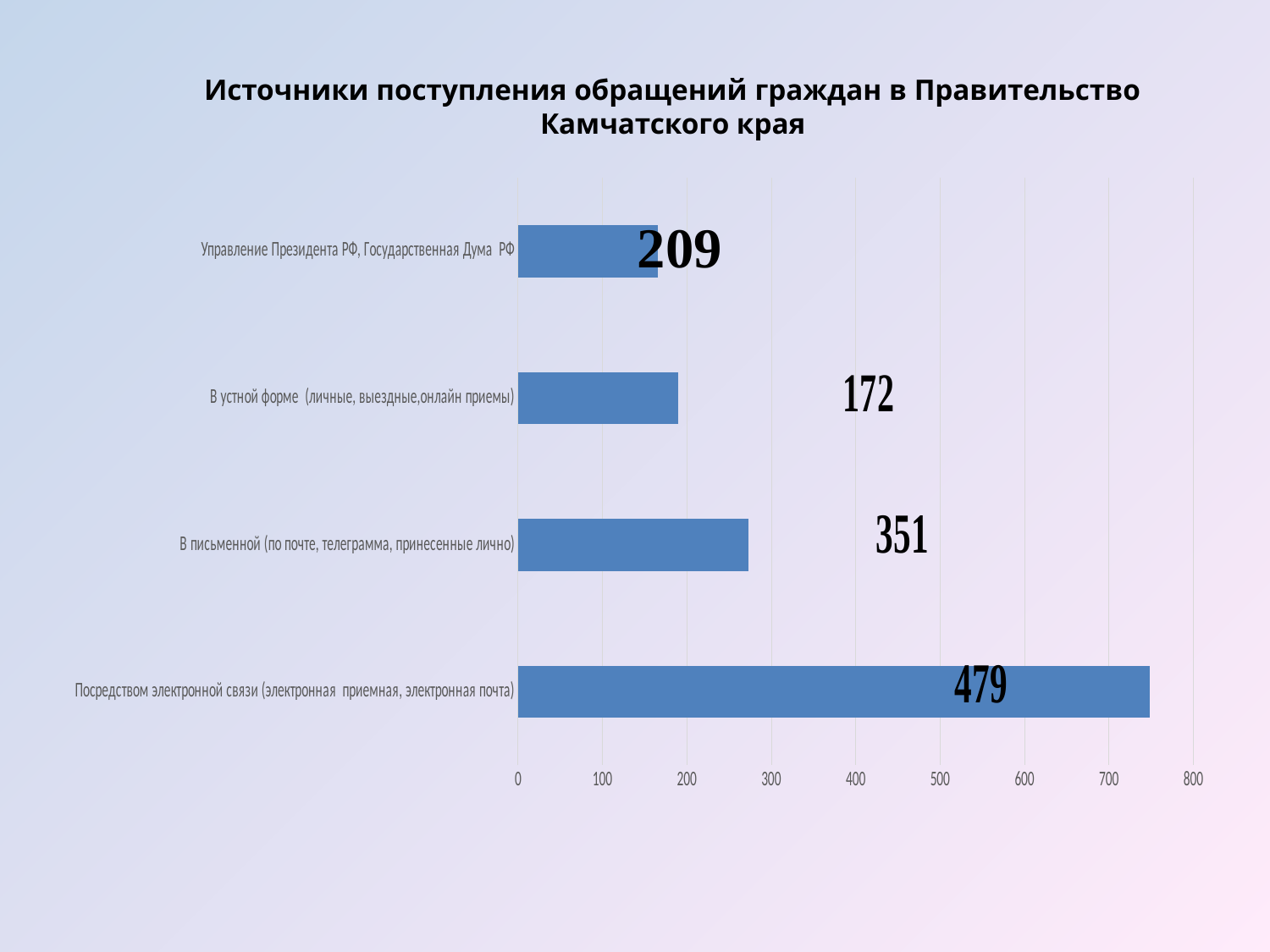
What is the maximum value shown on the horizontal axis? 800 What value is printed for "Управление Президента РФ, Государственная Дума РФ"? 209 Is the value for "Посредством электронной связи" greater or less than 400? greater What is the title of the chart? Источники поступления обращений граждан в Правительство Камчатского края What value is printed for "В устной форме (личные, выездные, онлайн приемы)"? 172 Which is larger: the value for "В письменной" or the value for "В устной форме"? В письменной Is the value for "В устной форме" greater or less than 300? less How many categories (sources of appeals) are shown in the chart? 4 Which source of appeals has the highest value? Посредством электронной связи (электронная приемная, электронная почта) What value is printed for "В письменной (по почте, телеграмма, принесенные лично)"? 351 What kind of chart is shown on the slide? bar chart What value is printed for "Посредством электронной связи (электронная приемная, электронная почта)"? 479